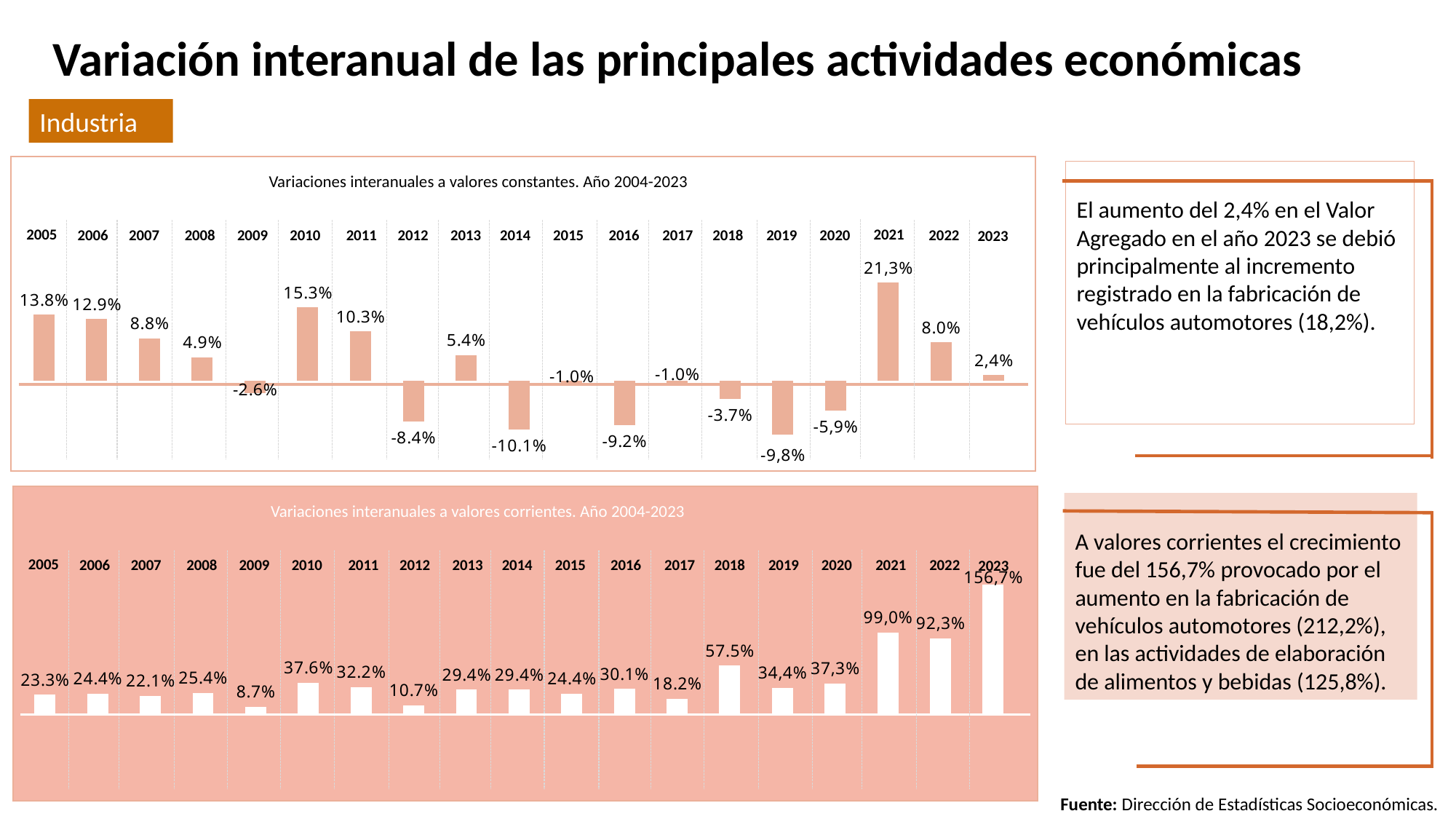
In the chart 'Variaciones interanuales a valores constantes. Año 2004-2023', which year has the highest value? 2021 In the chart 'Variaciones interanuales a valores corrientes. Año 2004-2023', what is the difference between the values for 2023 and 2021? 57,7% In the chart 'Variaciones interanuales a valores corrientes. Año 2004-2023', which year has the highest value? 2023 In the chart 'Variaciones interanuales a valores constantes. Año 2004-2023', what is the difference between the values for 2010 and 2011? 5.0% What type of chart is 'Variaciones interanuales a valores constantes. Año 2004-2023'? Bar chart How many years are shown in the chart 'Variaciones interanuales a valores corrientes. Año 2004-2023'? 19 In the chart 'Variaciones interanuales a valores corrientes. Año 2004-2023', which is larger, the value for 2021 or the value for 2022? 2021 In the chart 'Variaciones interanuales a valores constantes. Año 2004-2023', what is the value for 2021? 21,3% In the chart 'Variaciones interanuales a valores corrientes. Año 2004-2023', what is the value for 2018? 57.5% In the chart 'Variaciones interanuales a valores corrientes. Año 2004-2023', which year has the lowest value? 2009 In the chart 'Variaciones interanuales a valores constantes. Año 2004-2023', what is the value for 2014? -10.1%